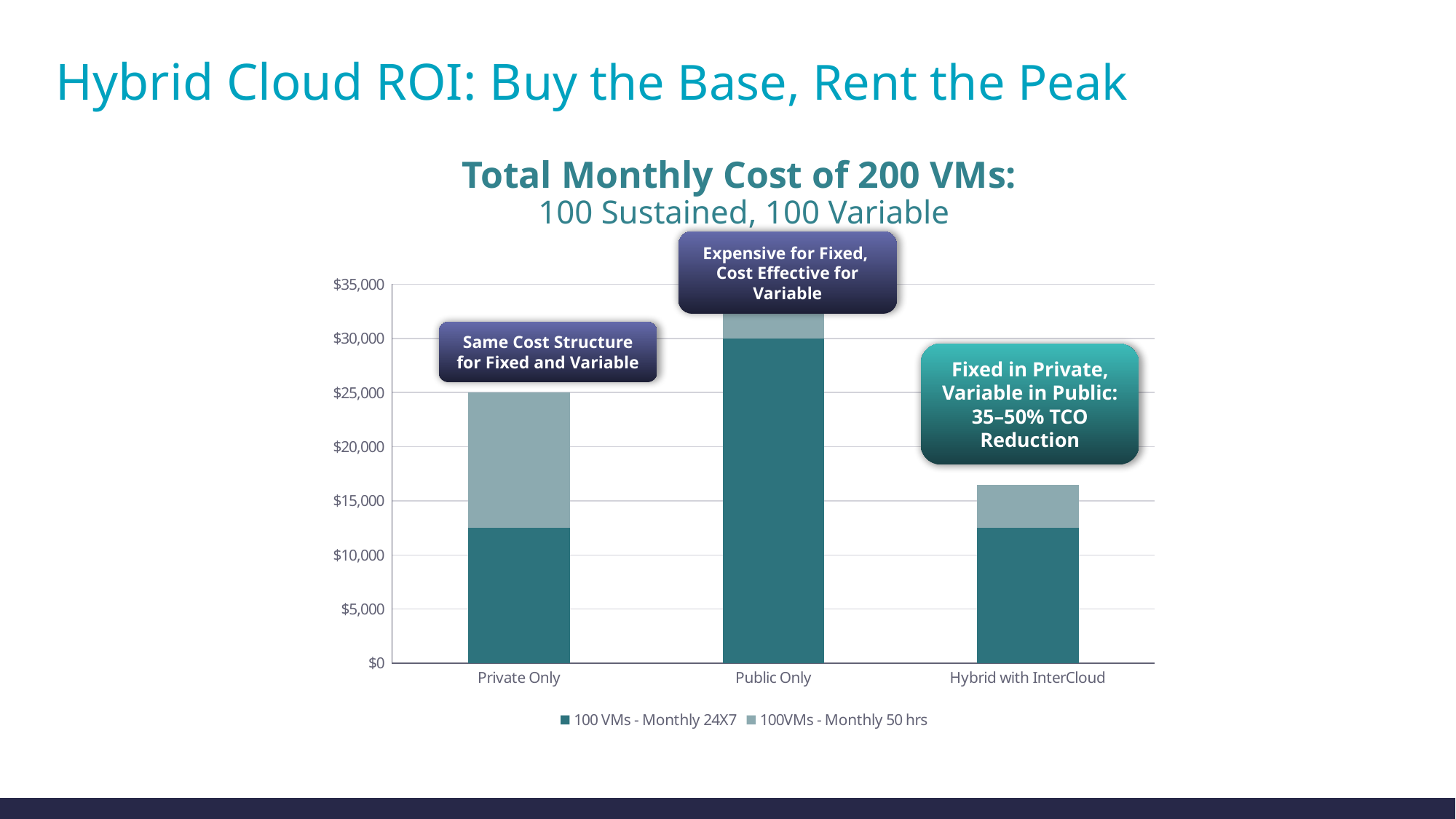
What is the value of the '100 VMs - Monthly 24X7' segment for Public Only? $30,000 Which series is shown in the lighter grey-teal colour in the legend? 100VMs - Monthly 50 hrs How many categories are shown on the x axis of the chart? 3 Which category has the lowest total monthly cost? Hybrid with InterCloud Which category has the highest total monthly cost? Public Only What is the main title of the chart? Total Monthly Cost of 200 VMs: Is the total monthly cost for Hybrid with InterCloud greater or less than $20,000? less What is the total monthly cost for Private Only? $25,000 How many series does the chart's legend list? 2 Which has a larger total monthly cost, Private Only or Hybrid with InterCloud? Private Only Is the '100 VMs - Monthly 24X7' value for Private Only greater or less than $15,000? less What kind of chart is shown on the slide? Stacked bar chart